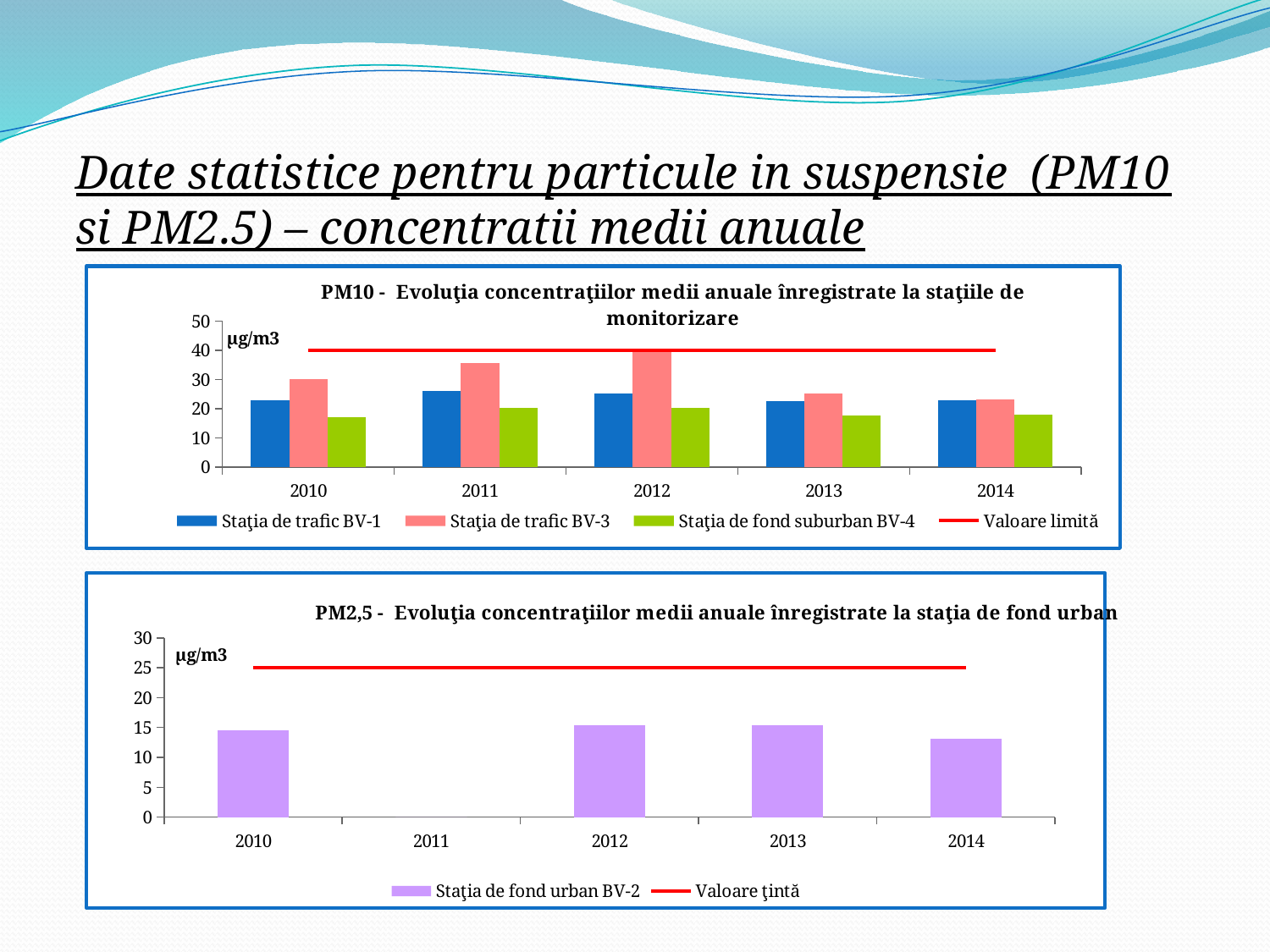
In the bottom chart (PM2,5), is the value for Staţia de fond urban BV-2 in 2014 greater or less than 15? less What kind of chart is the top chart (PM10)? bar chart In the top chart (PM10), does the value for Staţia de trafic BV-3 rise or fall from 2012 to 2014? fall In the bottom chart (PM2,5), which year has no bar plotted? 2011 In the top chart (PM10), which is larger in 2011: Staţia de trafic BV-1 or Staţia de trafic BV-3? Staţia de trafic BV-3 In the top chart (PM10), what unit is written next to the y axis? µg/m3 In the top chart (PM10), is the value for Staţia de fond suburban BV-4 in 2010 greater or less than 20? less In the top chart (PM10), how many entries does the legend list? 4 In the top chart (PM10), how many years are shown on the x axis? 5 In the bottom chart (PM2,5), how many entries does the legend list? 2 In the top chart (PM10), in which year is the value for Staţia de trafic BV-3 highest? 2012 In the top chart (PM10), is the value for Staţia de trafic BV-3 in 2011 greater or less than 30? greater